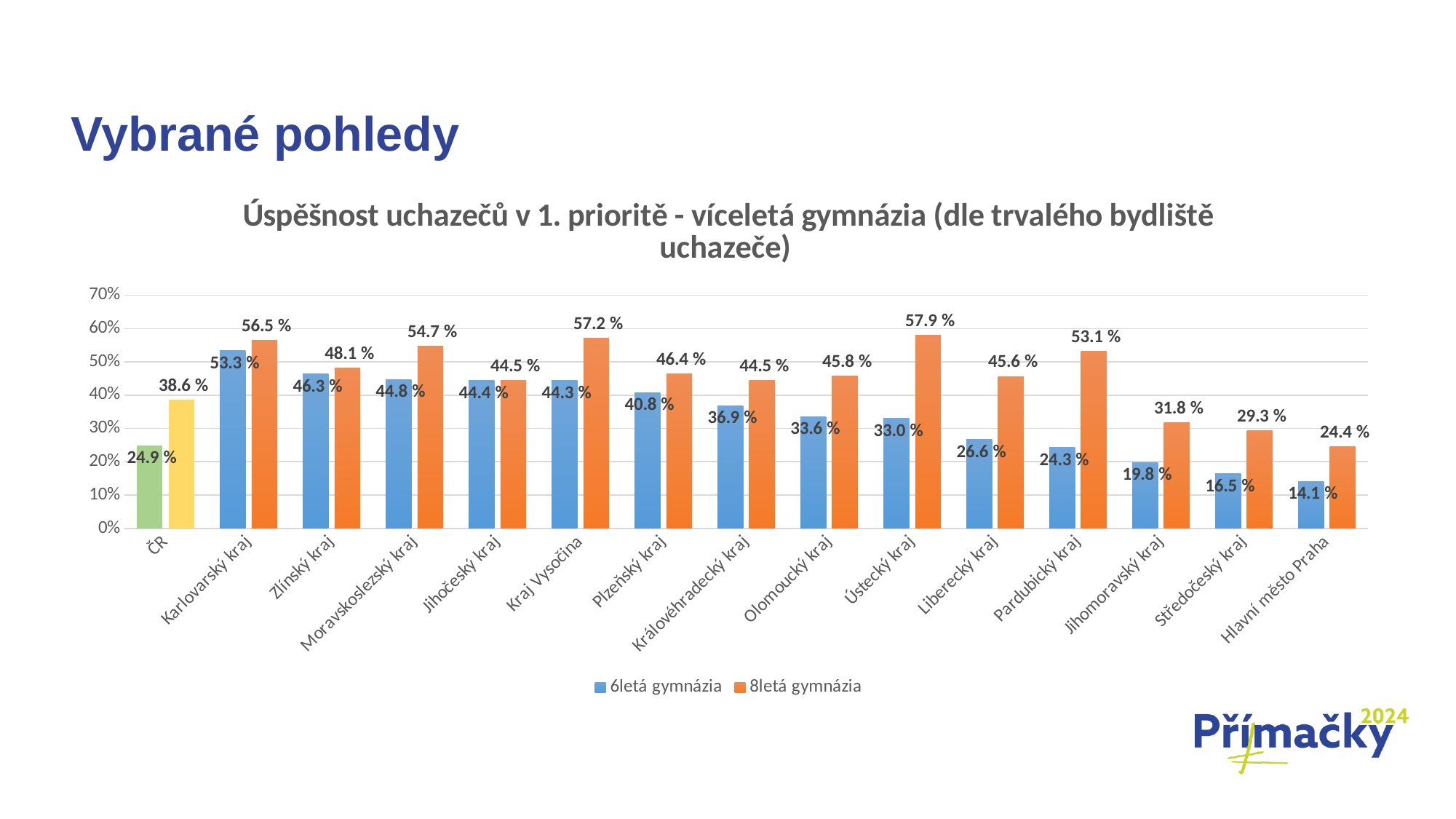
What is the value for 6letá gymnázia in Hlavní město Praha? 14.1 % What is the value for 6letá gymnázia for ČR? 24.9 % How many series does the legend list? 2 Is the 6letá gymnázia value for Liberecký kraj greater or less than 30%? less What type of chart is shown on the slide? bar chart What is the title of the chart? Úspěšnost uchazečů v 1. prioritě - víceletá gymnázia (dle trvalého bydliště uchazeče) How many categories are shown on the x axis? 15 Which category has the highest value for 6letá gymnázia? Karlovarský kraj Which is larger: the 8letá gymnázia value for Kraj Vysočina or for Moravskoslezský kraj? Kraj Vysočina What is the value for 8letá gymnázia in Ústecký kraj? 57.9 % What is the difference between the 8letá gymnázia and 6letá gymnázia values in Pardubický kraj? 28.8 % Which category has the lowest value for 8letá gymnázia? Hlavní město Praha